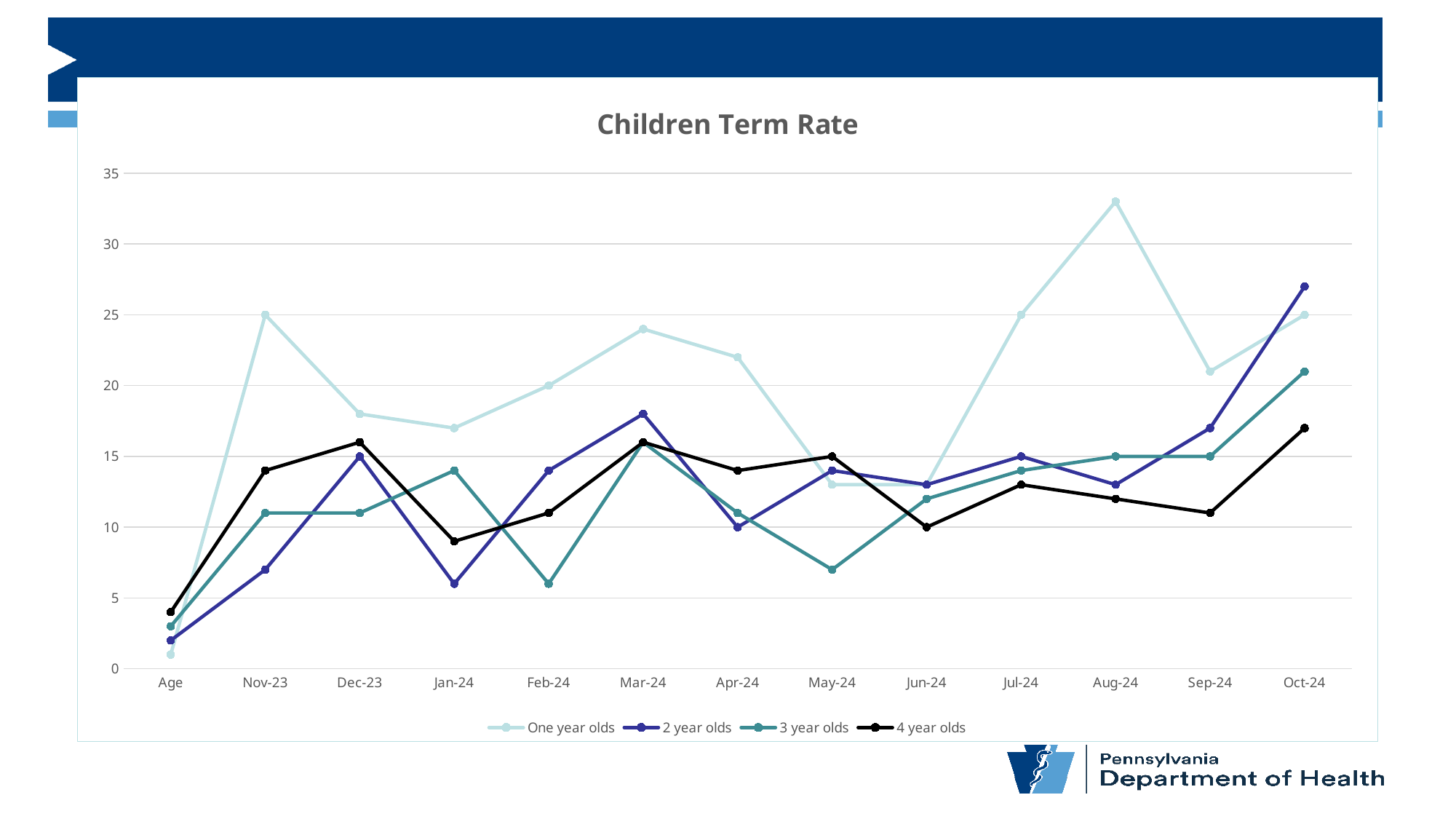
What is the title of the chart? Children Term Rate Is the value for 3 year olds at May-24 greater or less than 10? less How many categories are shown along the x axis? 13 What is the value for 2 year olds at Dec-23? 15 What is the value for 4 year olds at Jun-24? 10 How many series does the legend list? 4 Which series has the highest value at Aug-24? One year olds Do the values for One year olds rise or fall from Jun-24 to Aug-24? rise What kind of chart is shown on the slide? line chart What is the value for One year olds at Nov-23? 25 At Jan-24, which is larger: the value for 3 year olds or the value for 2 year olds? 3 year olds Is the value for One year olds at Aug-24 greater or less than 30? greater